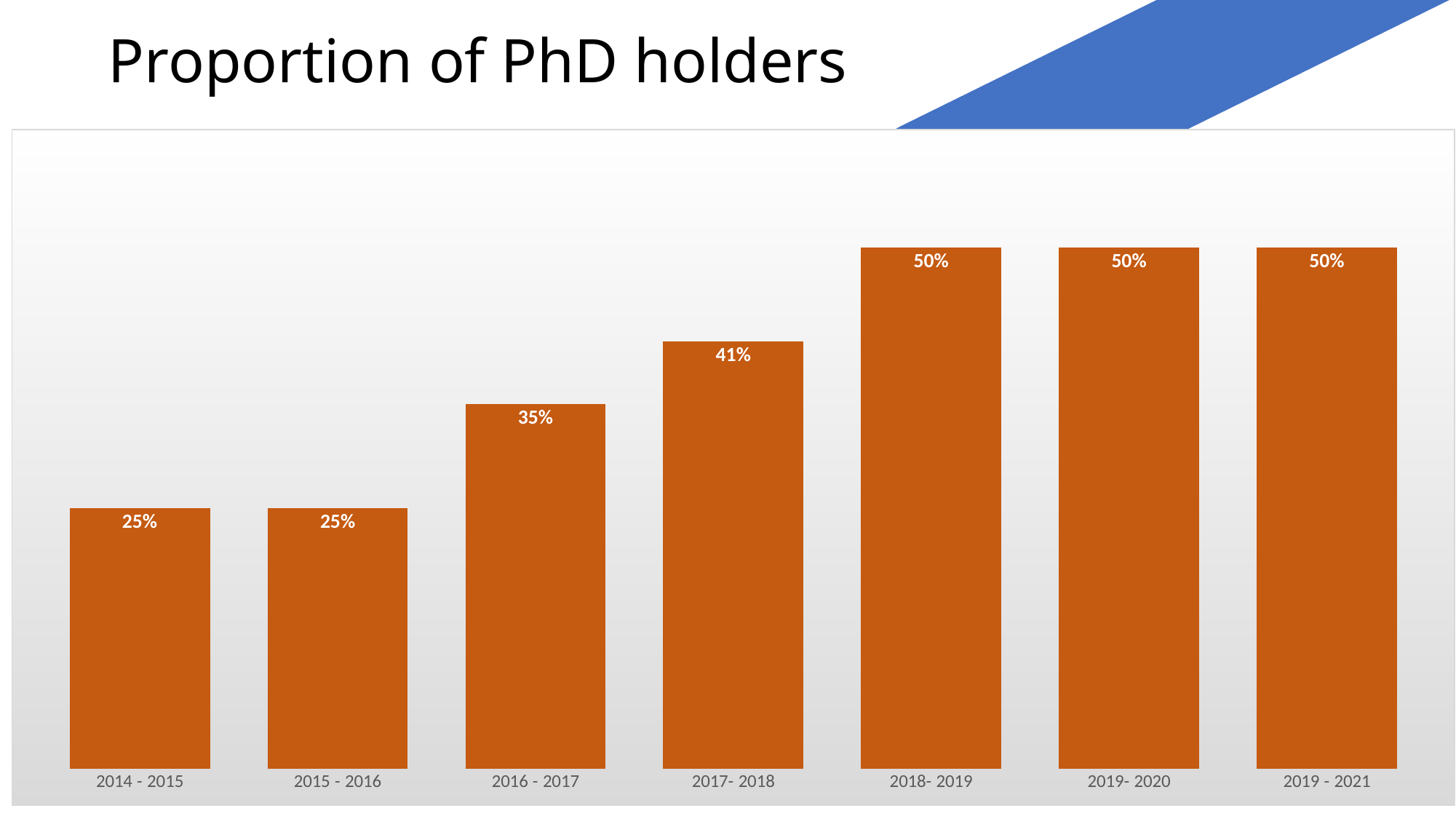
What kind of chart is shown on the slide? Bar chart What is the proportion of PhD holders for 2017- 2018? 41% What is the proportion of PhD holders for 2014 - 2015? 25% What is the proportion of PhD holders for 2016 - 2017? 35% What is the highest proportion of PhD holders shown on the chart? 50% Which period has a higher proportion of PhD holders, 2015 - 2016 or 2017- 2018? 2017- 2018 What is the proportion of PhD holders for 2019 - 2021? 50% What is the difference between the proportion of PhD holders in 2018- 2019 and in 2014 - 2015? 25% Does the proportion of PhD holders rise or fall from 2014 - 2015 to 2018- 2019? Rise How many periods are shown on the chart? 7 What is the lowest proportion of PhD holders shown on the chart? 25% What is the difference between the proportion of PhD holders in 2017- 2018 and in 2016 - 2017? 6%